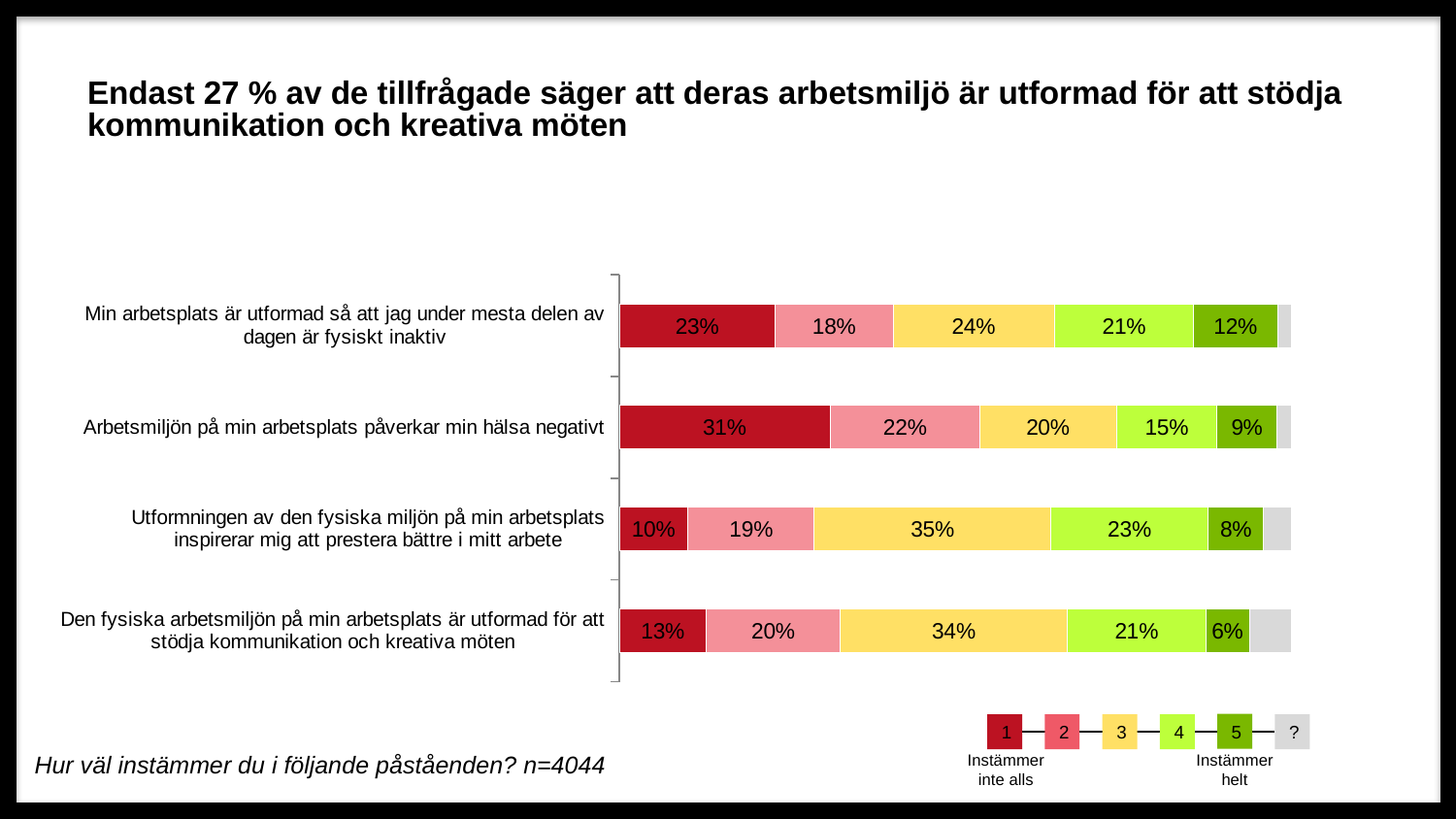
How many statements (categories) are shown in the chart? 4 What percentage answered 4 for "Min arbetsplats är utformad så att jag under mesta delen av dagen är fysiskt inaktiv"? 21% What is the difference in percentage points between the share answering 3 for "Utformningen av den fysiska miljön..." (35%) and for "Arbetsmiljön på min arbetsplats påverkar min hälsa negativt" (20%)? 15 percentage points Which statement has the lowest share of respondents answering 5 (Instämmer helt)? Den fysiska arbetsmiljön på min arbetsplats är utformad för att stödja kommunikation och kreativa möten What percentage answered 3 for "Utformningen av den fysiska miljön på min arbetsplats inspirerar mig att prestera bättre i mitt arbete"? 35% Which is larger: the share answering 2 for "Arbetsmiljön på min arbetsplats påverkar min hälsa negativt" or for "Min arbetsplats är utformad så att jag under mesta delen av dagen är fysiskt inaktiv"? Arbetsmiljön på min arbetsplats påverkar min hälsa negativt (22%) How many response options does the legend list? 6 What kind of chart is shown on the slide? Stacked horizontal bar chart What percentage answered 5 (Instämmer helt) for "Den fysiska arbetsmiljön på min arbetsplats är utformad för att stödja kommunikation och kreativa möten"? 6% What is the sample size (n) stated on the slide? n=4044 What percentage of respondents answered 1 (Instämmer inte alls) for "Arbetsmiljön på min arbetsplats påverkar min hälsa negativt"? 31% Which statement has the highest share of respondents answering 1 (Instämmer inte alls)? Arbetsmiljön på min arbetsplats påverkar min hälsa negativt